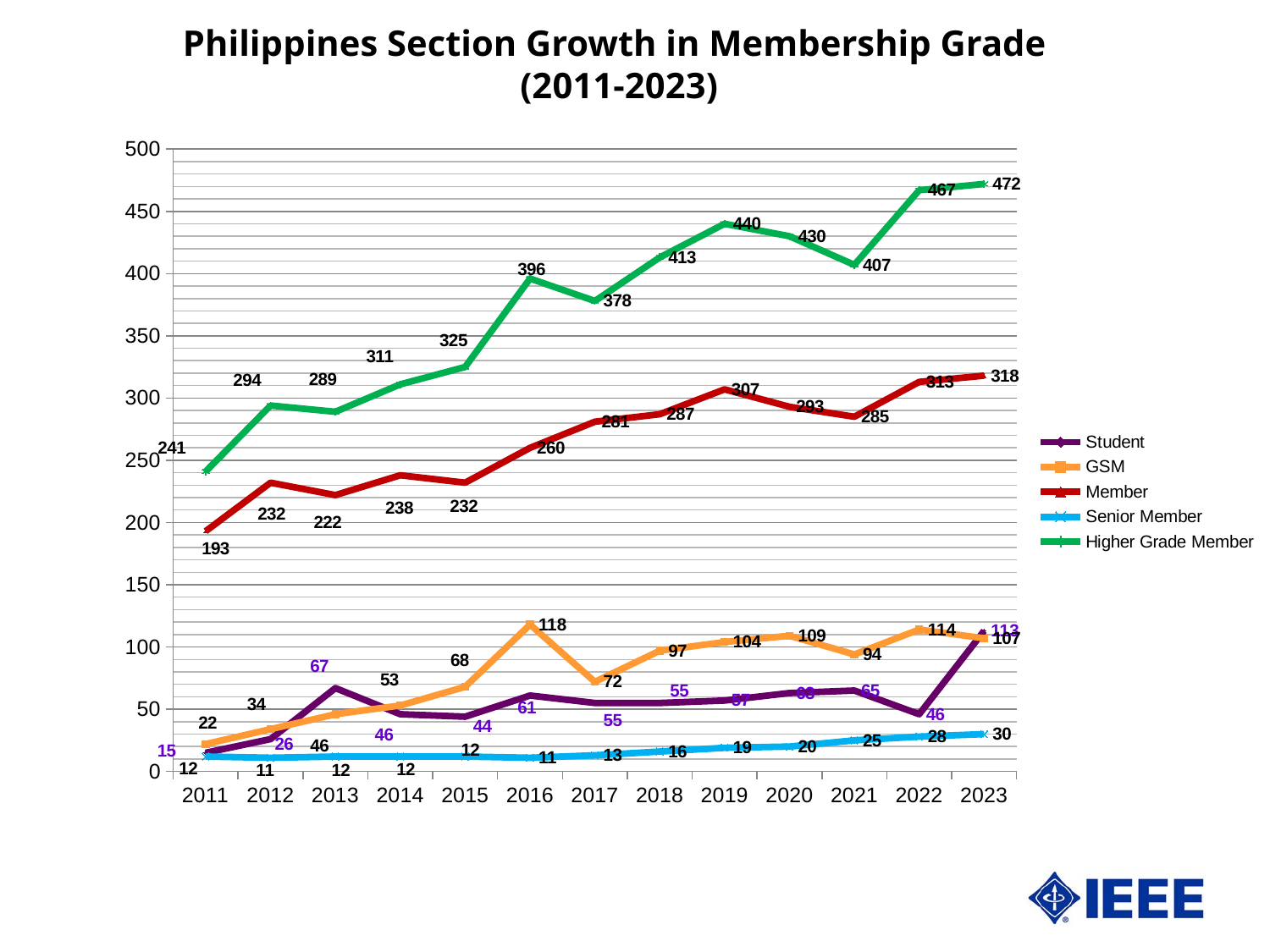
Does the Senior Member series generally rise or fall from 2011 to 2023? rise How many years are plotted along the x axis? 13 What kind of chart is shown on the slide? line chart What is the value for Member in 2011? 193 In which year is the GSM value highest? 2016 How many series does the legend list? 5 What is the value for Senior Member in 2023? 30 What is the difference between the Higher Grade Member values in 2023 and 2011? 231 What is the value for Higher Grade Member in 2023? 472 What is the value for GSM in 2016? 118 Which is larger in 2016, the GSM value or the Student value? GSM In which year is the Higher Grade Member value highest? 2023